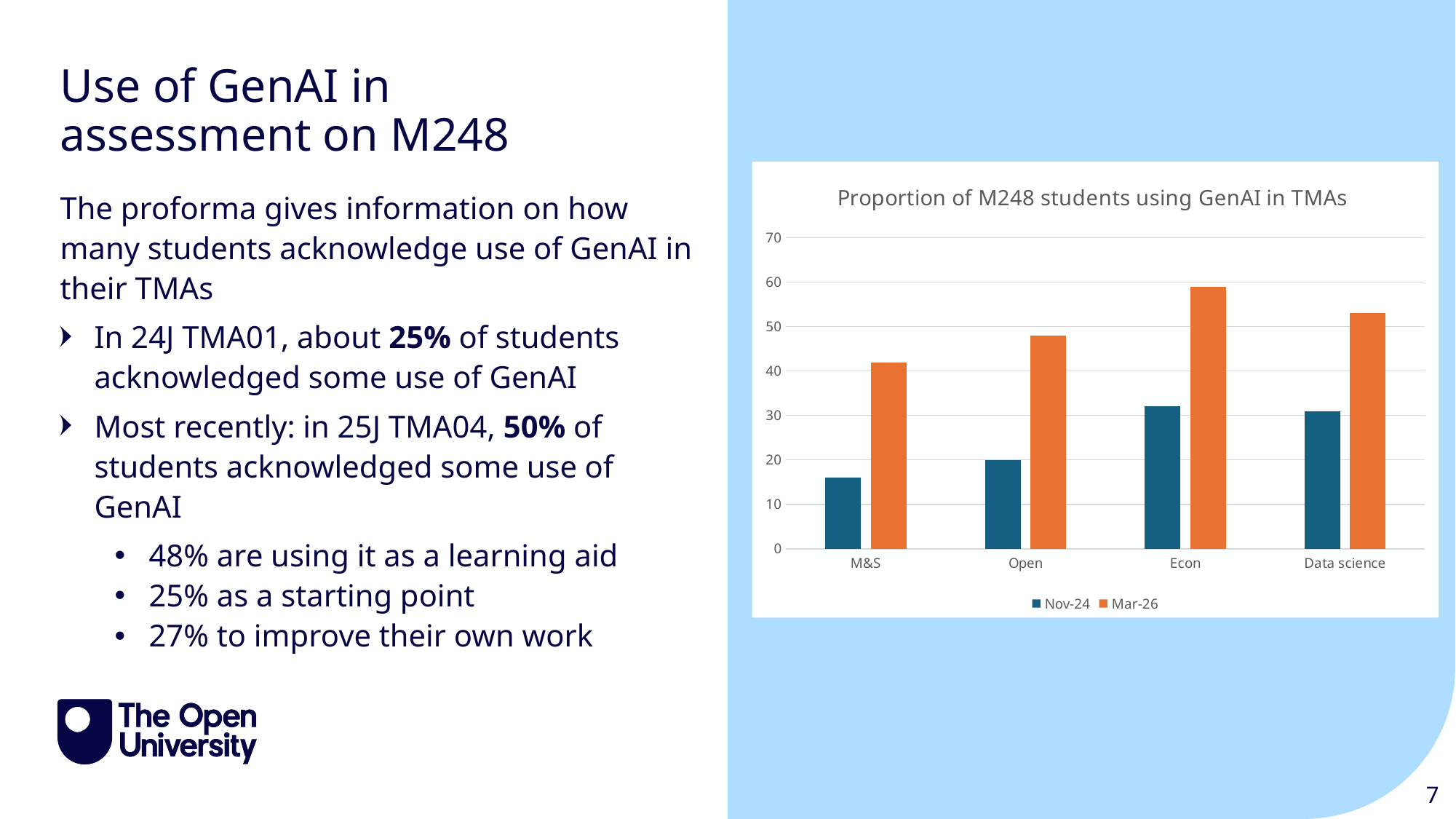
Is the Nov-24 value for M&S greater or less than 20? less Is the Mar-26 value for Econ greater or less than 50? greater What is the title of the chart? Proportion of M248 students using GenAI in TMAs What kind of chart is shown on the slide? bar chart Which is larger: the Mar-26 value for Open or the Mar-26 value for M&S? Open For Data science, which is larger: the Nov-24 value or the Mar-26 value? Mar-26 How many series does the chart legend list? 2 How many categories are shown on the x axis of the chart? 4 Which category has the highest Mar-26 value? Econ Which category has the lowest Nov-24 value? M&S Is the Nov-24 value for Econ greater or less than 40? less Which category has the lowest Mar-26 value? M&S